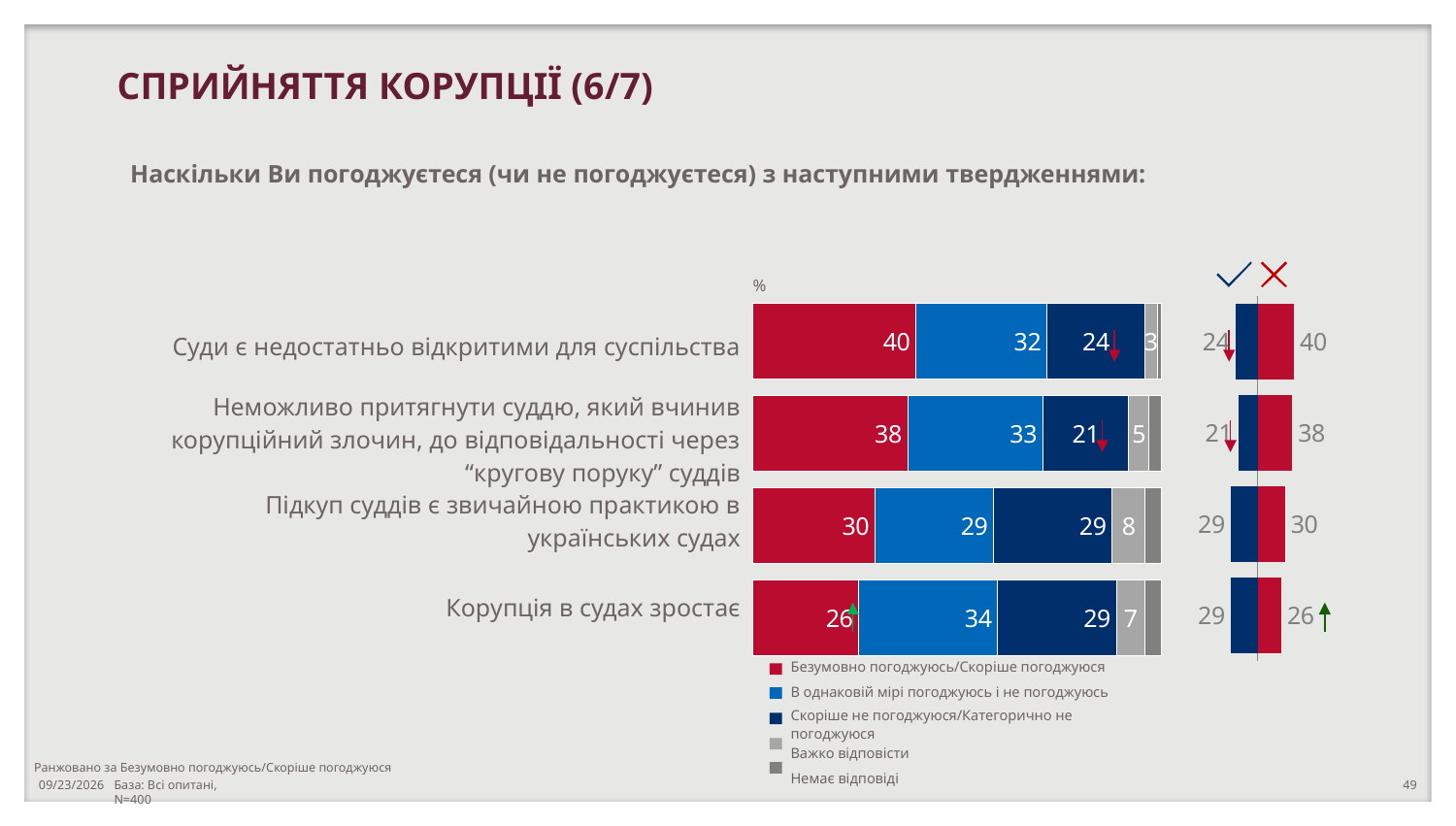
What type of chart is used to show the responses to the statements? Stacked bar chart Which statement has the highest share of respondents who definitely or rather agree? Суди є недостатньо відкритими для суспільства How many series does the legend of the stacked bar chart list? 5 What percentage of respondents definitely or rather agree (Безумовно погоджуюсь/Скоріше погоджуюся) that courts are insufficiently open to society (Суди є недостатньо відкритими для суспільства)? 40 Which statement has the lowest share of respondents who definitely or rather agree? Корупція в судах зростає How many statements are shown in the stacked bar chart? 4 What is the 'Важко відповісти' value for the statement 'Підкуп суддів є звичайною практикою в українських судах'? 8 What is the value of the 'Скоріше не погоджуюся/Категорично не погоджуюся' segment for the statement 'Корупція в судах зростає'? 29 For the statement 'Корупція в судах зростає', which is larger: the share who agree or the share who disagree? The share who disagree (29) Which legend entry is shown in red in the stacked bar chart? Безумовно погоджуюсь/Скоріше погоджуюся What is the 'В однаковій мірі погоджуюсь і не погоджуюсь' value for the statement about the impossibility of holding a judge accountable due to 'кругова порука'? 33 What is the difference between the agree share for 'Суди є недостатньо відкритими для суспільства' (40) and for 'Корупція в судах зростає' (26)? 14